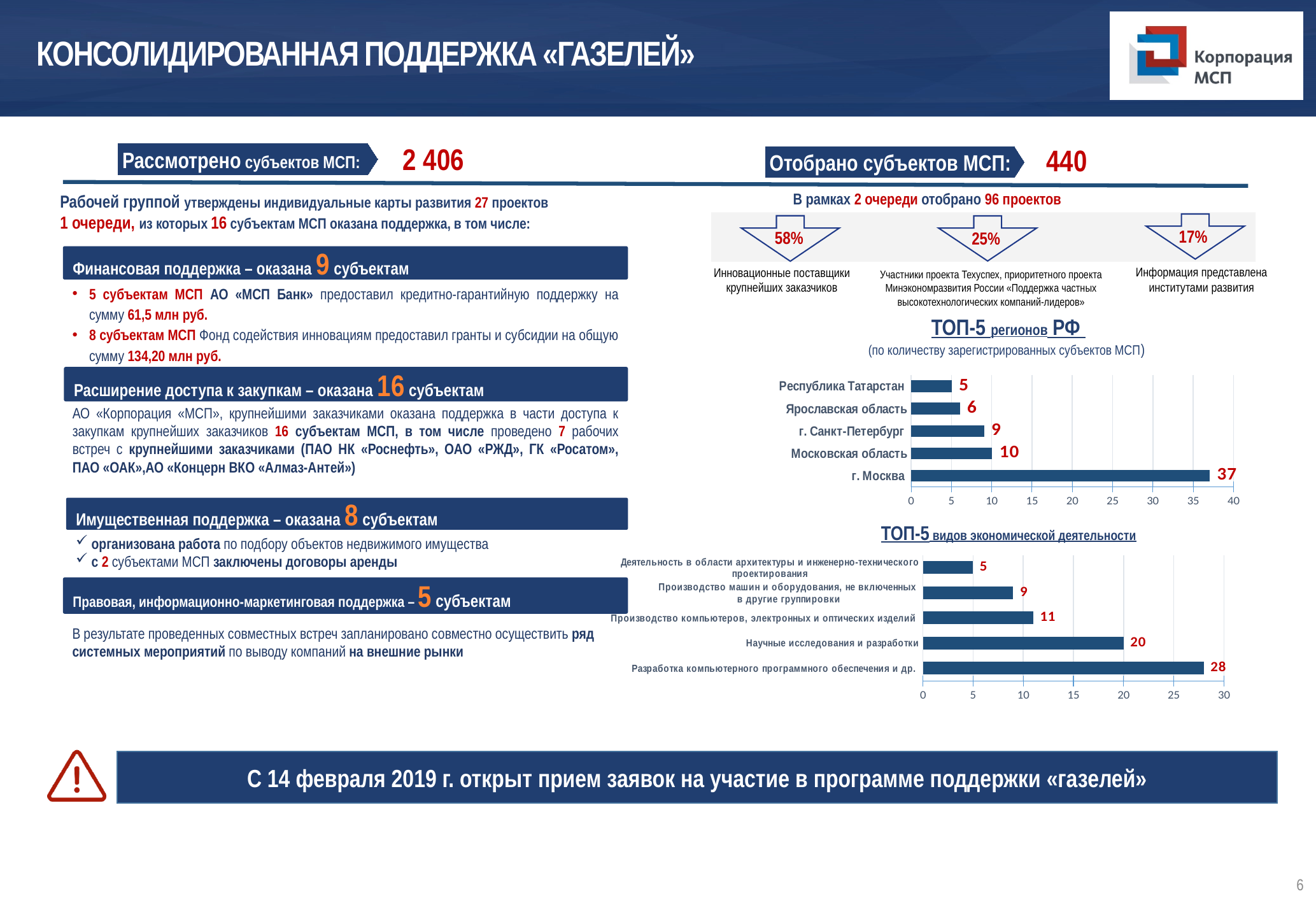
In the chart "ТОП-5 видов экономической деятельности", which is larger: Научные исследования и разработки or Производство машин и оборудования, не включенных в другие группировки? Научные исследования и разработки In the chart "ТОП-5 регионов РФ", which region has the lowest value? Республика Татарстан In the chart "ТОП-5 видов экономической деятельности", what is the difference between Разработка компьютерного программного обеспечения и др. and Научные исследования и разработки? 8 In the chart "ТОП-5 регионов РФ", what is the value for г. Москва? 37 In the chart "ТОП-5 регионов РФ", what is the difference between г. Москва and г. Санкт-Петербург? 28 In the chart "ТОП-5 видов экономической деятельности", what is the value for Производство компьютеров, электронных и оптических изделий? 11 In the chart "ТОП-5 регионов РФ", what kind of chart is it? bar chart In the chart "ТОП-5 видов экономической деятельности", which activity has the highest value? Разработка компьютерного программного обеспечения и др. In the chart "ТОП-5 видов экономической деятельности", what is the value for Научные исследования и разработки? 20 In the chart "ТОП-5 регионов РФ", how many regions are shown? 5 In the chart "ТОП-5 регионов РФ", what is the value for Московская область? 10 In the chart "ТОП-5 видов экономической деятельности", what is the maximum value shown on the x axis? 30